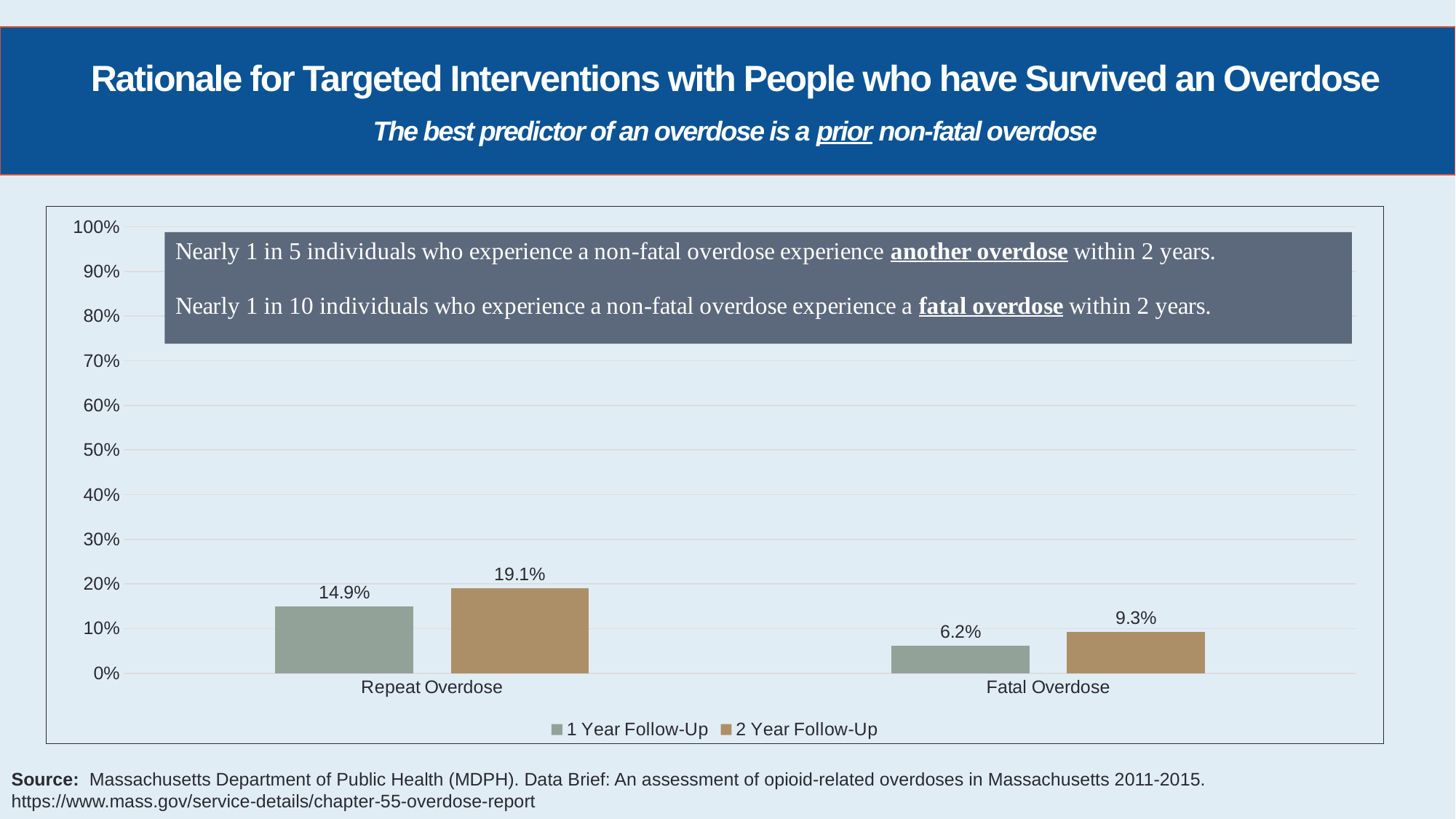
Which bar has the lowest value on the chart? Fatal Overdose, 1 Year Follow-Up What is the difference between the 2 Year Follow-Up and 1 Year Follow-Up values for Fatal Overdose? 3.1% How many categories are shown on the x axis? 2 What is the difference between the 2 Year Follow-Up and 1 Year Follow-Up values for Repeat Overdose? 4.2% What is the value for Fatal Overdose at 2 Year Follow-Up? 9.3% Which bar has the highest value on the chart? Repeat Overdose, 2 Year Follow-Up What is the value for Repeat Overdose at 1 Year Follow-Up? 14.9% What kind of chart is shown on the slide? Bar chart What is the value for Fatal Overdose at 1 Year Follow-Up? 6.2% Which is larger: the 1 Year Follow-Up value for Repeat Overdose or the 2 Year Follow-Up value for Fatal Overdose? 1 Year Follow-Up value for Repeat Overdose What is the value for Repeat Overdose at 2 Year Follow-Up? 19.1% How many series does the legend list? 2